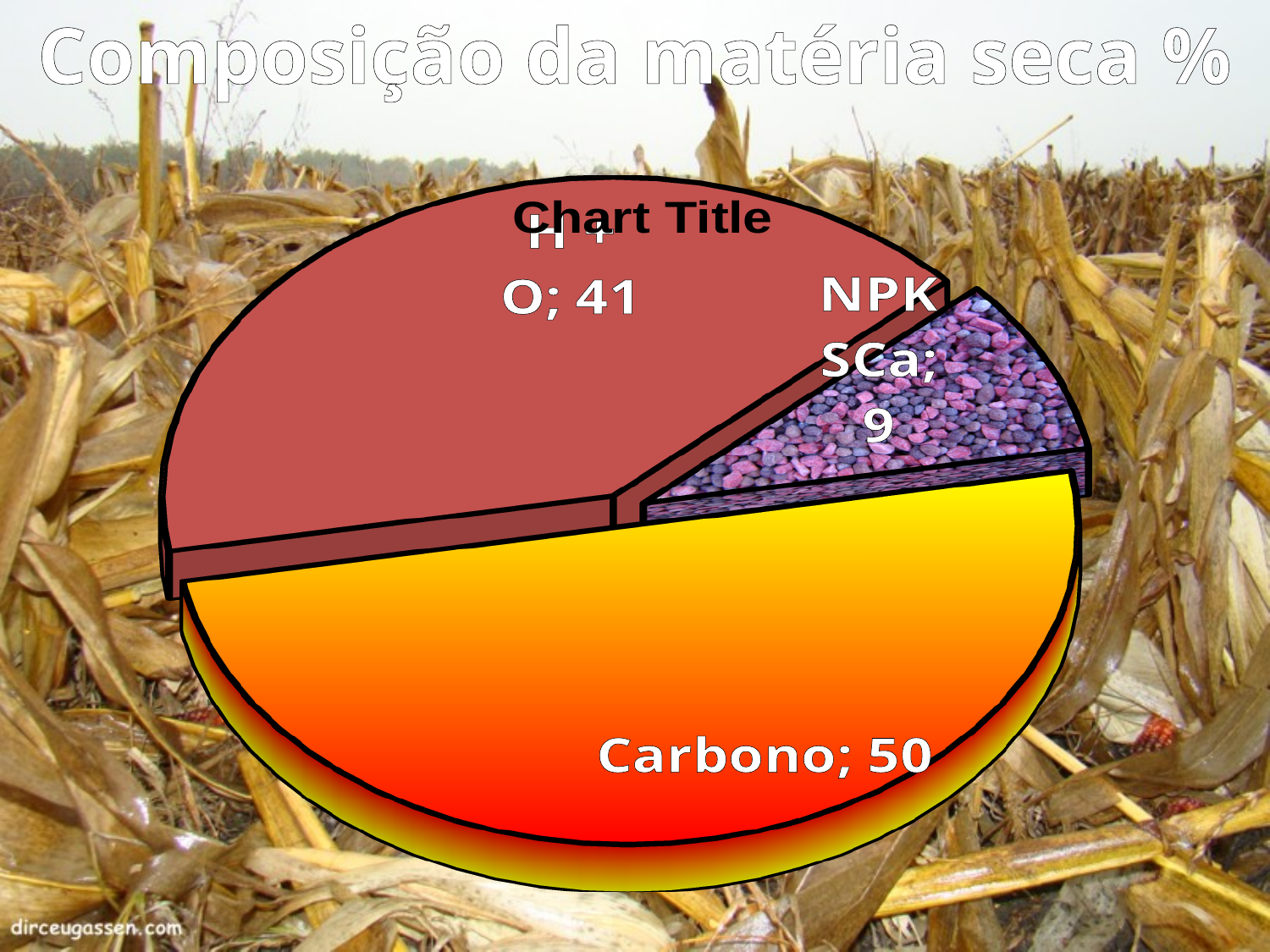
What is the value shown for NPK SCa? 9 Which is larger, the value for H + O or the value for NPK SCa? H + O What is the difference between the values for Carbono and H + O? 9 What is the value shown for H + O? 41 Which slice of the pie has the smallest value? NPK SCa What is the value shown for Carbono? 50 Which slice of the pie has the largest value? Carbono What share of the pie does the Carbono slice represent? 50% What is the title of the slide? Composição da matéria seca % What is the difference between the values for H + O and NPK SCa? 32 What type of chart is shown on the slide? pie chart How many slices does the pie chart have? 3